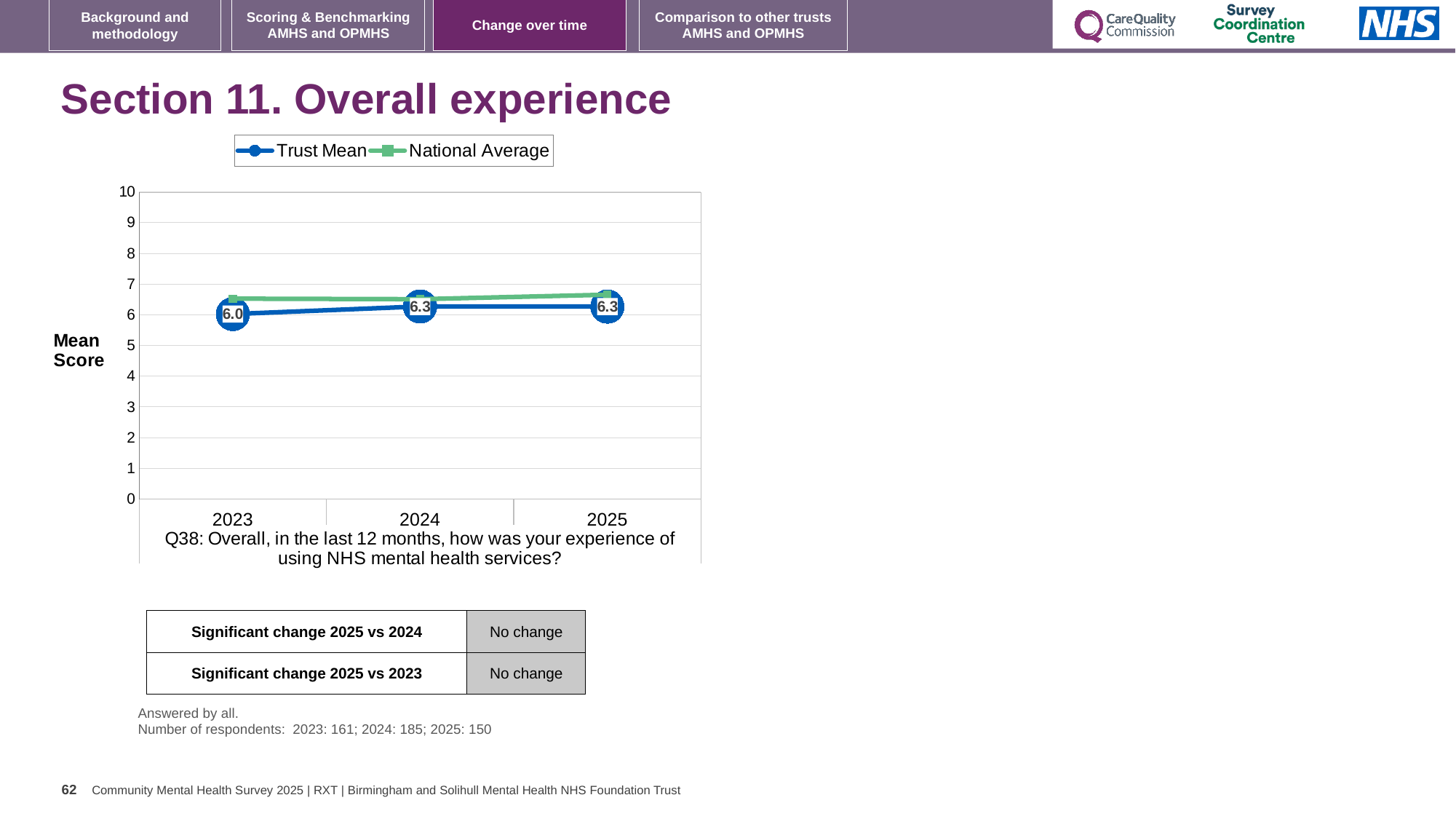
What kind of chart is shown on the slide? Line chart What is the label on the y axis of the chart? Mean Score What is the Trust Mean score for 2023? 6.0 What is the Trust Mean score for 2025? 6.3 What is the difference between the Trust Mean score in 2024 and in 2023? 0.3 Is the National Average value for 2023 greater or less than 6? greater Does the Trust Mean score rise or fall from 2023 to 2025? Rise How many years are plotted on the x axis? 3 How many series does the chart legend list? 2 In which year is the Trust Mean score lowest? 2023 Which is larger, the Trust Mean score in 2023 or in 2024? 2024 What is the Trust Mean score for 2024? 6.3